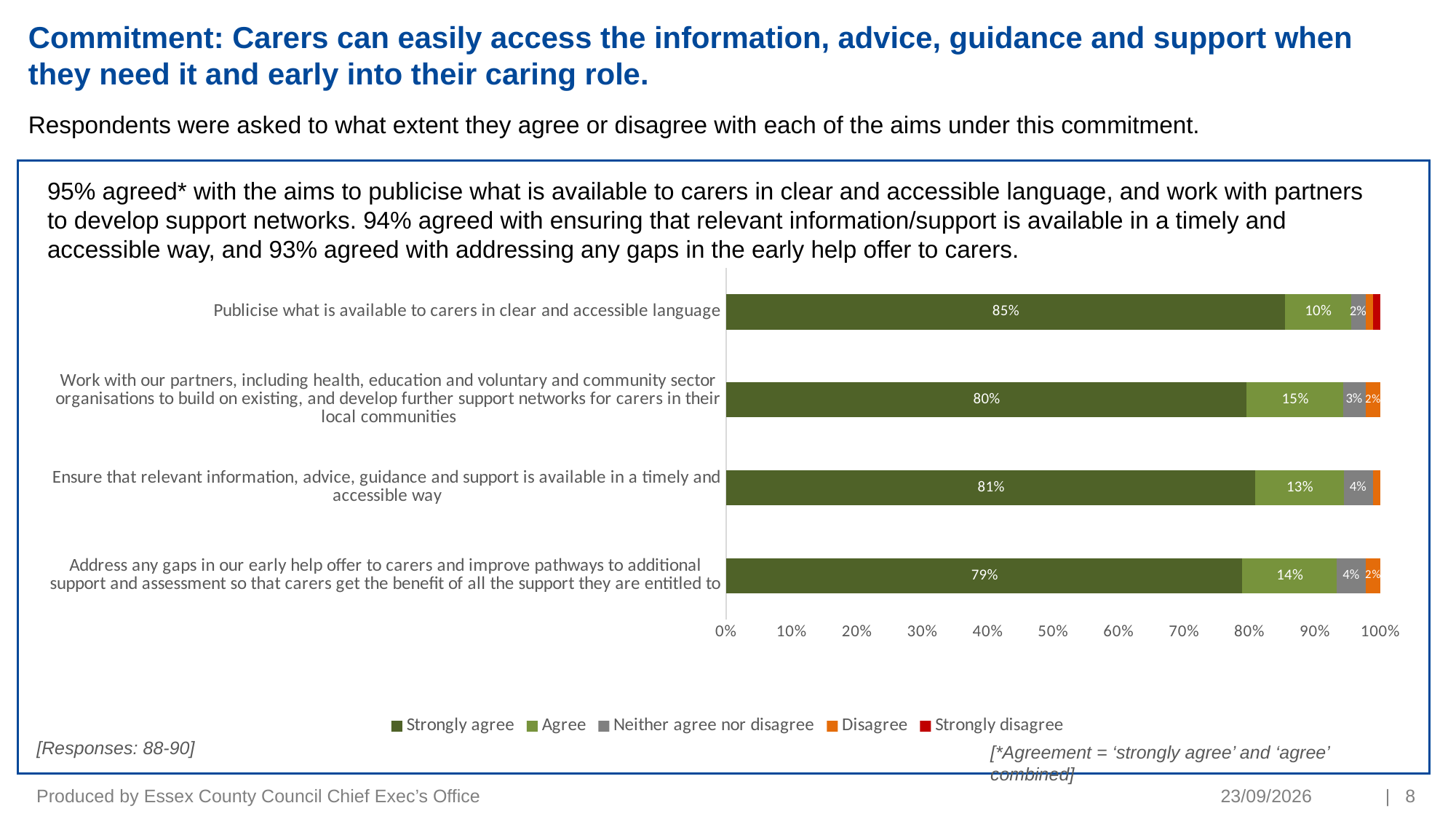
What is the difference between the 'Strongly agree' values for 'Publicise what is available to carers' and 'Address any gaps in our early help offer'? 6% Which legend entry is shown in red? Strongly disagree Which aim has the highest 'Strongly agree' percentage? Publicise what is available to carers in clear and accessible language How many series does the chart legend list? 5 How many aims (categories) are plotted in the chart? 4 What percentage of respondents strongly agreed with 'Publicise what is available to carers in clear and accessible language'? 85% What is the 'Strongly agree' value for 'Address any gaps in our early help offer to carers'? 79% Which aim has the lowest 'Strongly agree' percentage? Address any gaps in our early help offer to carers and improve pathways to additional support and assessment What is the 'Neither agree nor disagree' value for 'Ensure that relevant information, advice, guidance and support is available in a timely and accessible way'? 4% What is the 'Agree' value for the aim to work with partners to develop further support networks for carers? 15% Which has a larger 'Agree' value: 'Work with our partners' or 'Ensure that relevant information, advice, guidance and support is available in a timely and accessible way'? Work with our partners What kind of chart is shown on the slide? Stacked bar chart